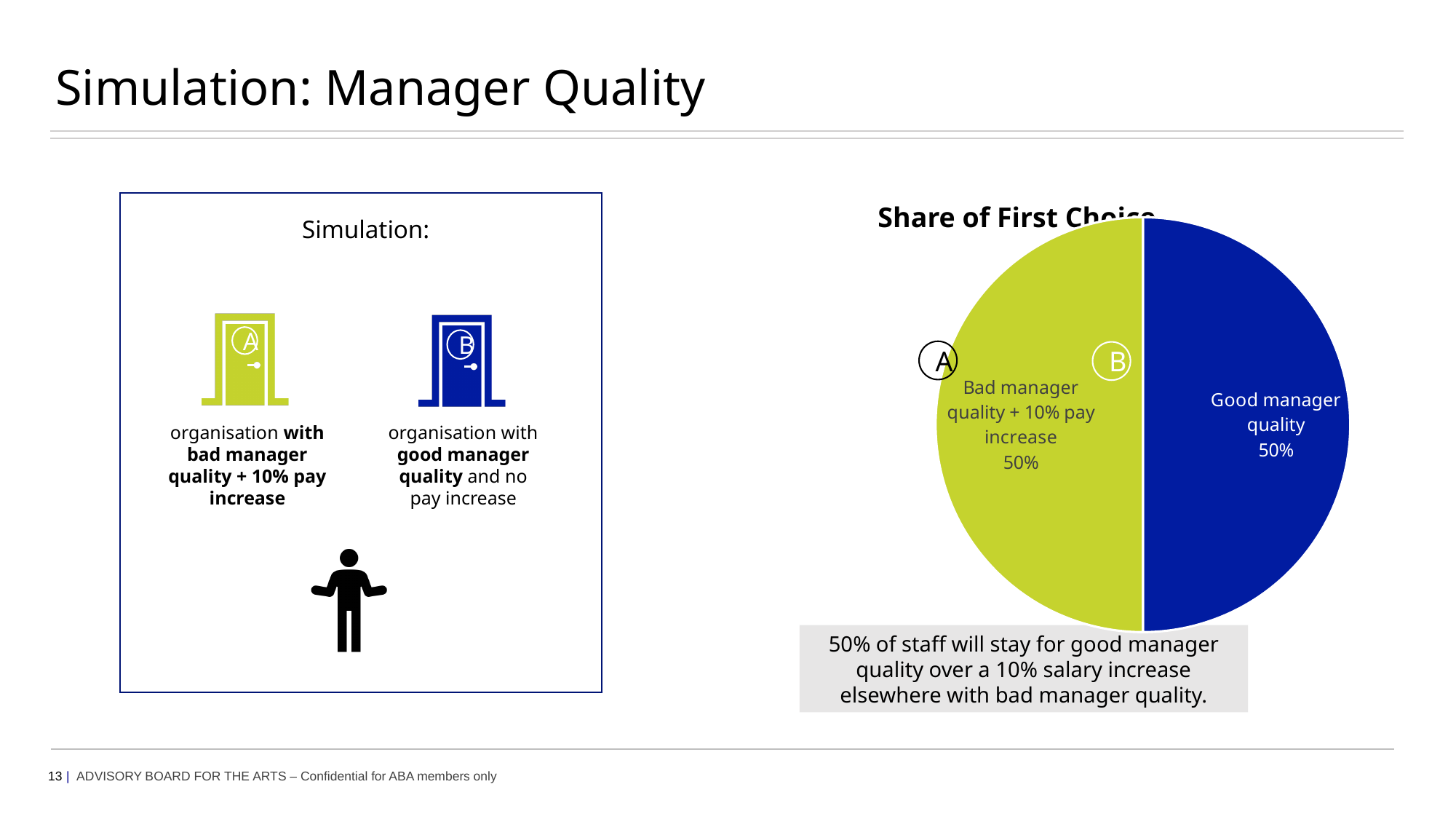
What kind of chart is shown on the slide? pie chart Which letter marks the "Bad manager quality + 10% pay increase" slice of the pie chart? A Which letter marks the "Good manager quality" slice of the pie chart? B What colour is the "Good manager quality" slice of the pie chart? blue Is the share for "Good manager quality" larger than, smaller than, or equal to the share for "Bad manager quality + 10% pay increase"? equal What is the difference between the share for "Good manager quality" and the share for "Bad manager quality + 10% pay increase"? 0% What share of the pie is labelled "Bad manager quality + 10% pay increase"? 50% What share of the pie is labelled "Good manager quality"? 50% What is the title of the pie chart? Share of First Choice How many slices does the pie chart have? 2